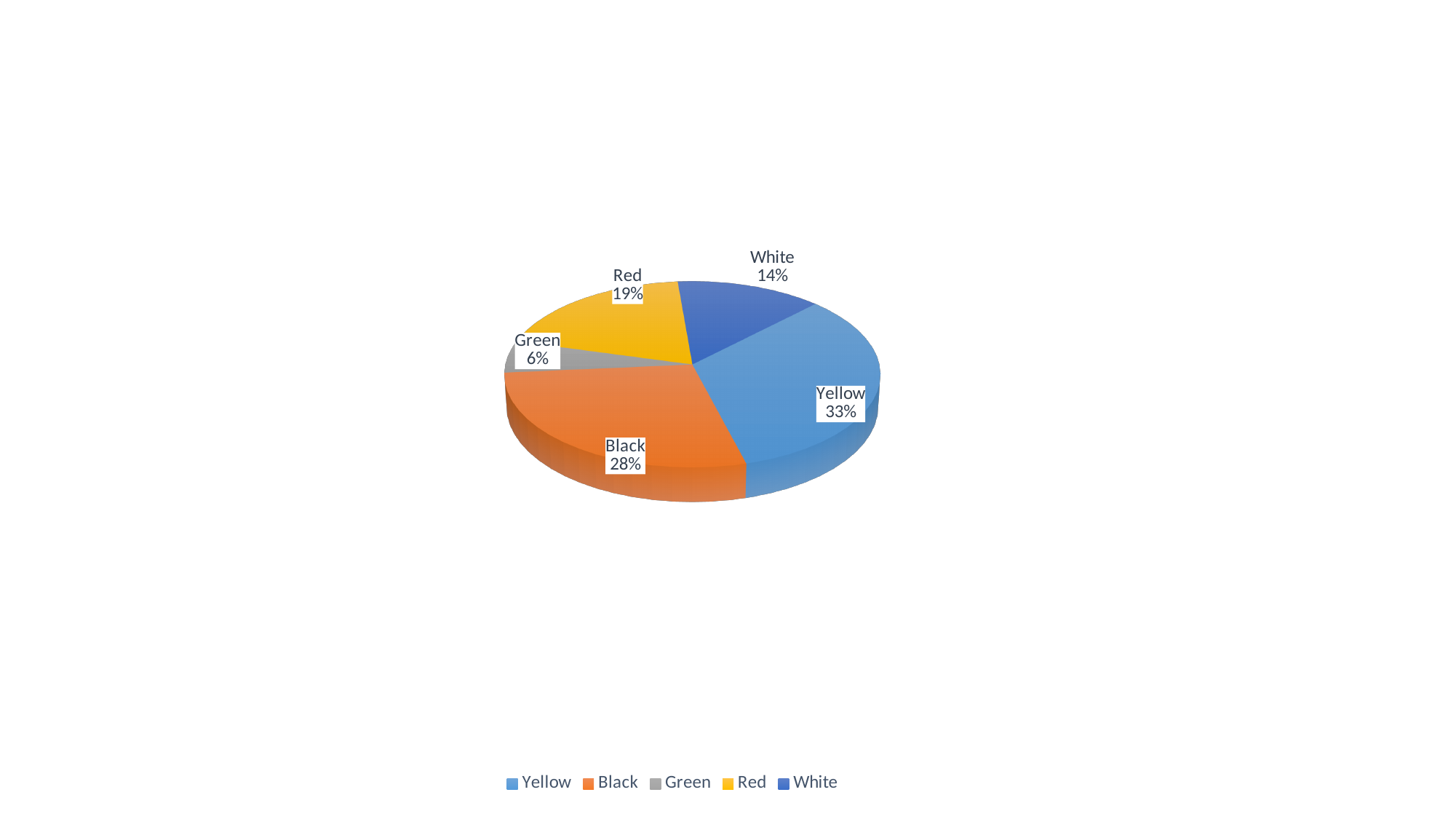
What is the value shown for the Black slice? 28% What share of the pie does the Yellow slice represent? 33% Which slice is the smallest? Green What is the value shown for Red? 19% What is the difference in percentage points between Yellow and Black? 5 Which slice is the largest? Yellow What share of the pie does White represent? 14% What percentage is shown for Green? 6% Which is larger, Red or White? Red How many entries does the legend list? 5 What kind of chart is shown on the slide? Pie chart How many slices does the pie chart have? 5